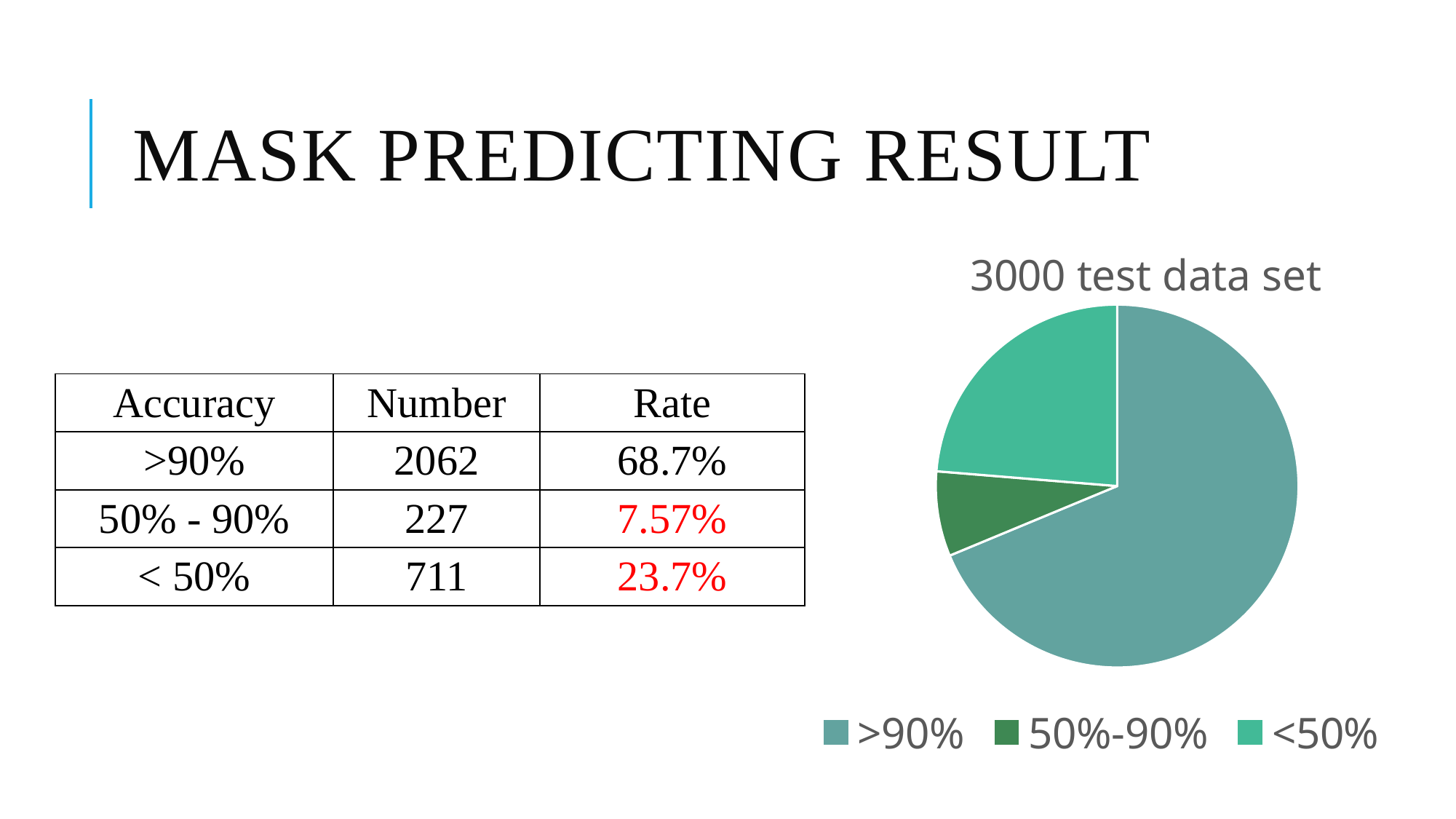
According to the table on the slide, what share of the pie does the <50% slice represent? 23.7% Which legend entry of the pie chart is shown in the darkest green colour? 50%-90% What kind of chart is shown on the slide? pie chart In the pie chart, which slice is larger: <50% or 50%-90%? <50% How many entries does the pie chart's legend list? 3 Which category has the largest slice in the pie chart? >90% In the pie chart, which slice is larger: >90% or <50%? >90% Does the >90% slice take up more or less than half of the pie chart? more According to the table on the slide, what share of the pie does the >90% slice represent? 68.7% Which category has the smallest slice in the pie chart? 50%-90% What is the title of the pie chart? 3000 test data set How many slices does the pie chart have? 3